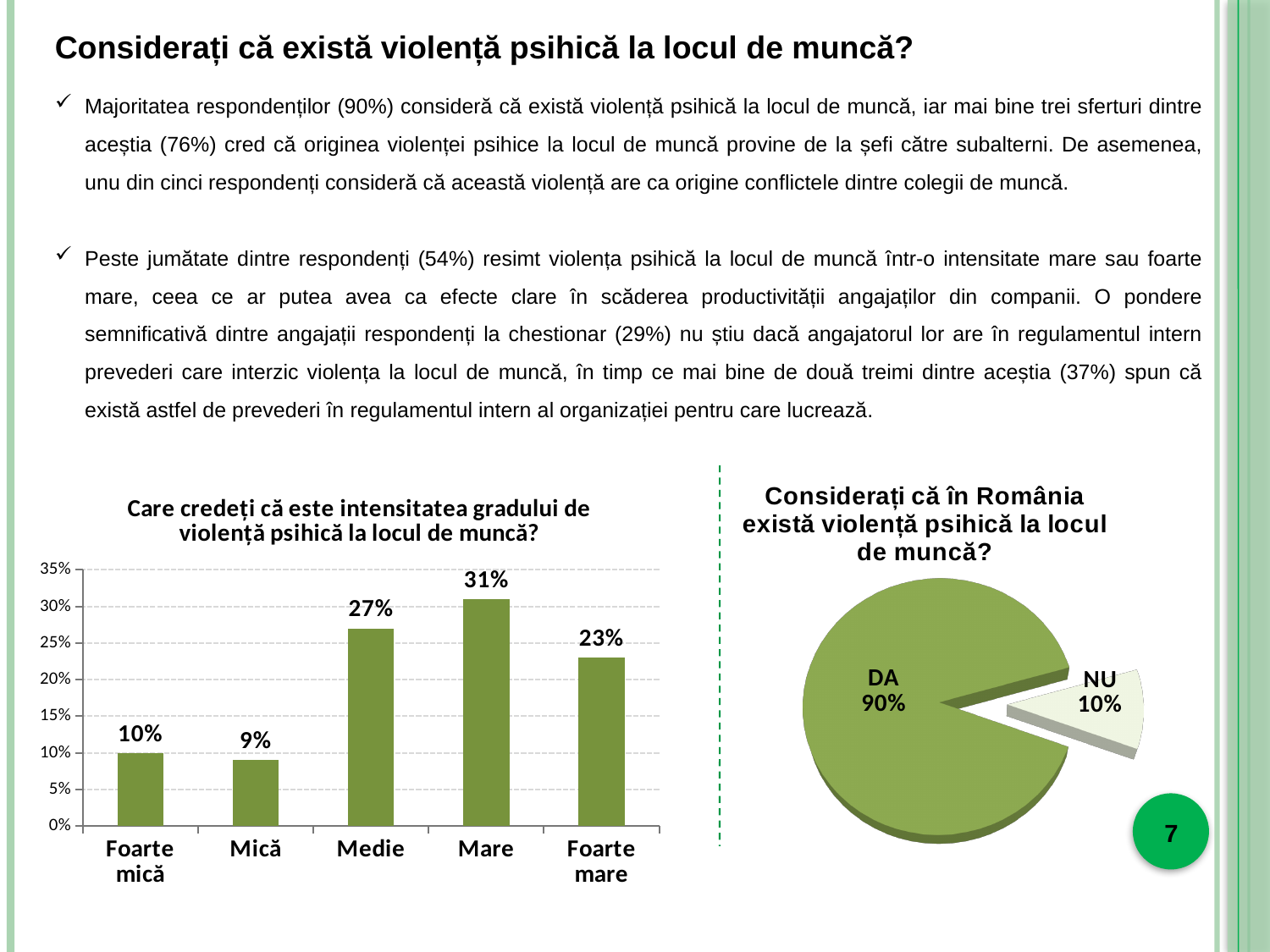
In the bar chart on the left, which category has the lowest value? Mică In the bar chart 'Care credeți că este intensitatea gradului de violență psihică la locul de muncă?', what is the value for 'Mare'? 31% In the bar chart on the left, what is the value for 'Foarte mică'? 10% What kind of chart is the chart on the right of the slide? pie chart In the pie chart on the right, what is the value for 'NU'? 10% What kind of chart is the chart on the left of the slide? bar chart In the bar chart on the left, which category has the highest value? Mare In the bar chart on the left, is the value for 'Medie' greater or less than 25%? greater How many categories are shown in the bar chart on the left? 5 In the pie chart 'Considerați că în România există violență psihică la locul de muncă?', what share does 'DA' have? 90% In the bar chart on the left, which is larger, the value for 'Medie' or the value for 'Foarte mare'? Medie In the bar chart on the left, what is the difference between the values for 'Mare' and 'Foarte mare'? 8%